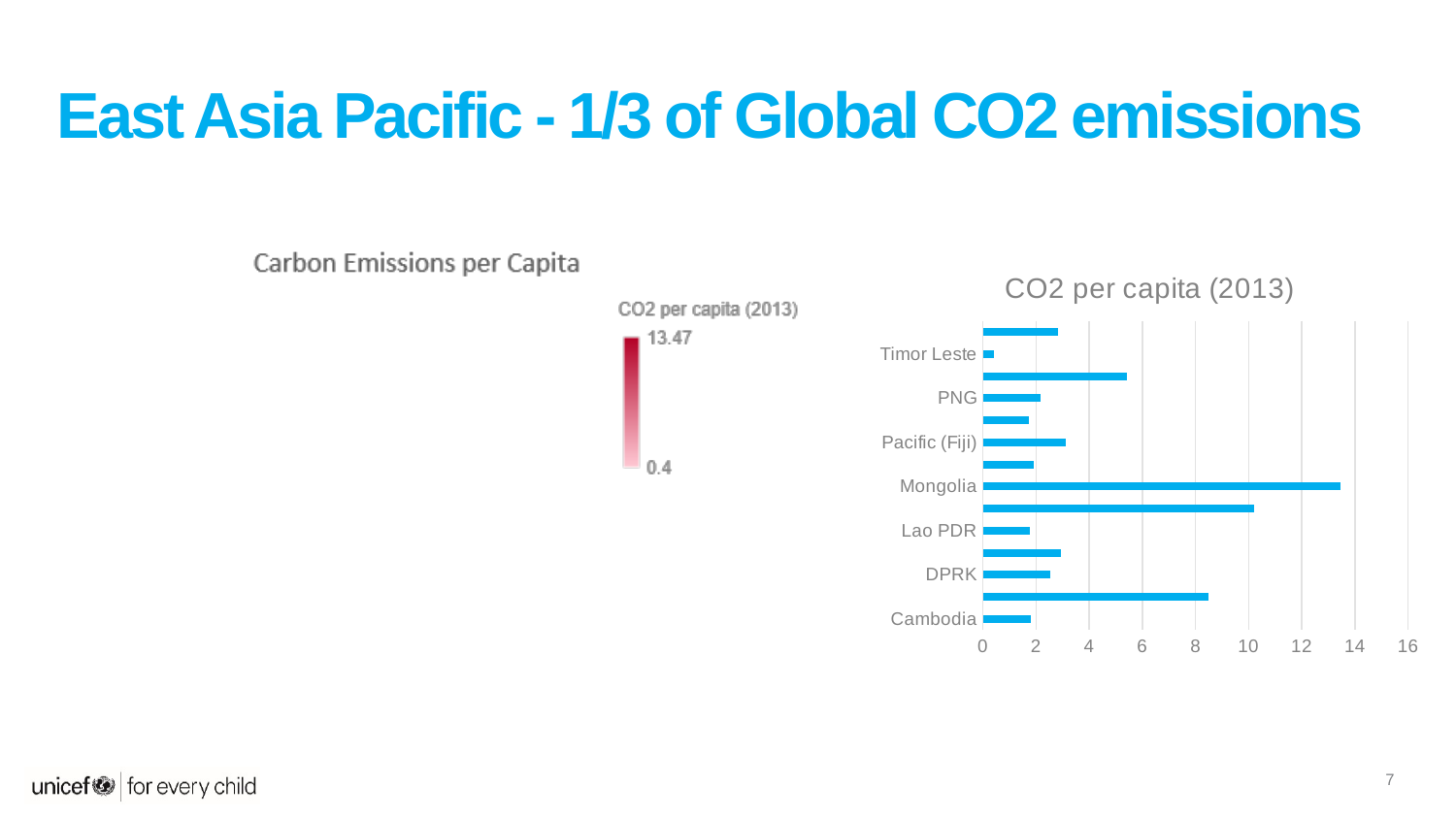
Is the CO2 per capita value for Pacific (Fiji) greater or less than 2? greater Is the CO2 per capita value for Timor Leste greater or less than 2? less Is the CO2 per capita value for PNG greater or less than 4? less Which has a higher CO2 per capita (2013): Pacific (Fiji) or Timor Leste? Pacific (Fiji) Which labelled country has the lowest CO2 per capita (2013) in the bar chart? Timor Leste Which labelled country has the highest CO2 per capita (2013) in the bar chart? Mongolia What type of chart is used to show CO2 per capita (2013)? bar chart What are the maximum and minimum values shown on the colour scale legend for CO2 per capita (2013)? 13.47 and 0.4 Which has a higher CO2 per capita (2013): Mongolia or PNG? Mongolia What is the title of the bar chart on the slide? CO2 per capita (2013)